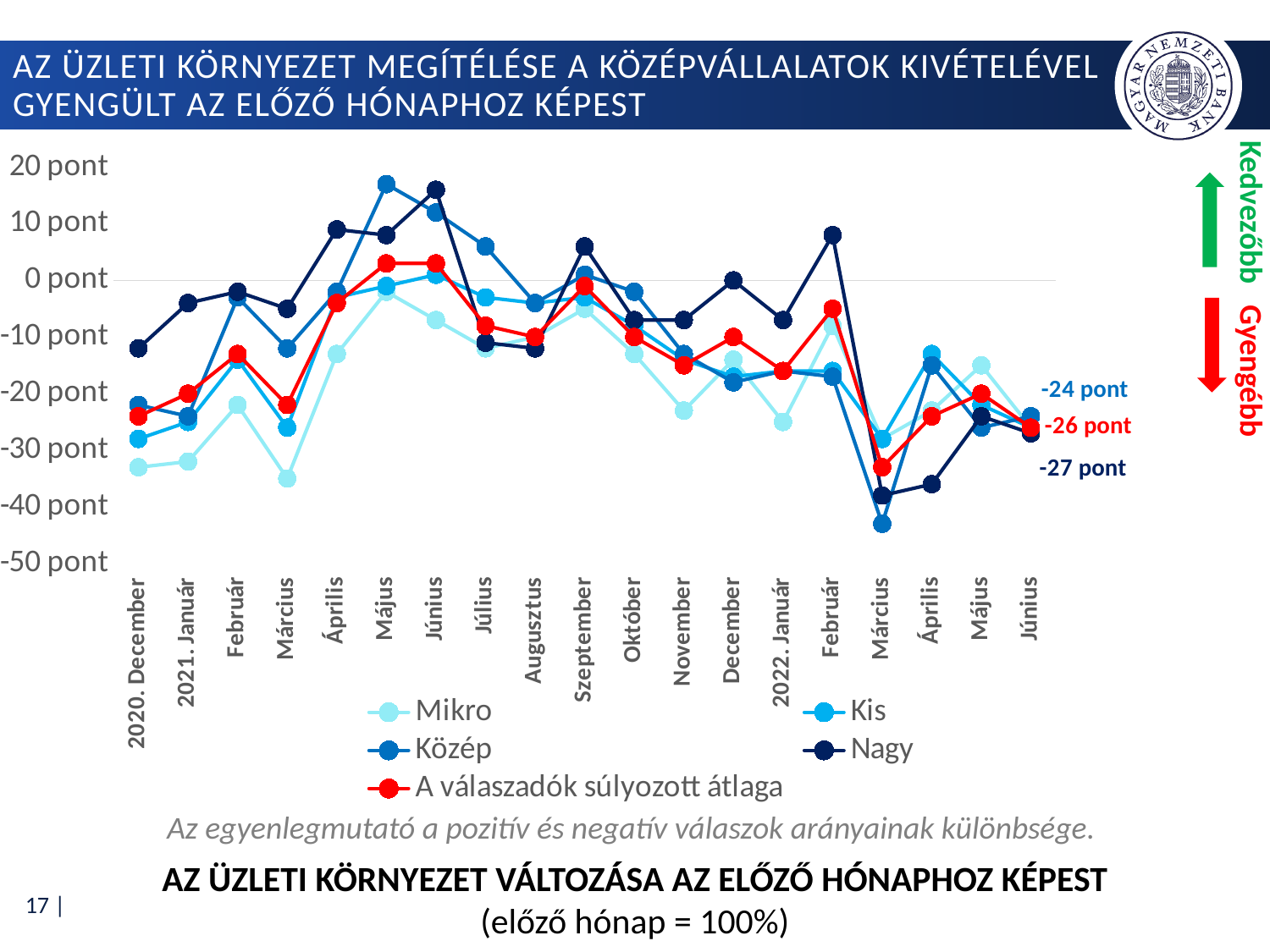
What is the difference between the labelled 2022 Június values of 'A válaszadók súlyozott átlaga' (-26 pont) and 'Nagy' (-27 pont)? 1 pont Which series has the lowest value in 2022 Március? Közép How many series does the legend list? 5 What value is labelled for the 'Nagy' series at 2022 Június? -27 pont What value is labelled for 'A válaszadók súlyozott átlaga' at 2022 Június? -26 pont Do the series rise or fall from 2022 Február to 2022 Március? fall In 2020 December, which series has the higher value, 'Nagy' or 'Mikro'? Nagy What kind of chart is shown on the slide? line chart Is the value for 'Nagy' in 2022 Március greater or less than -30 pont? less Which series has the highest value in 2021 Május? Közép Is the value for 'Közép' in 2021 Május greater or less than 10 pont? greater How many months (points) are shown along the x axis? 19